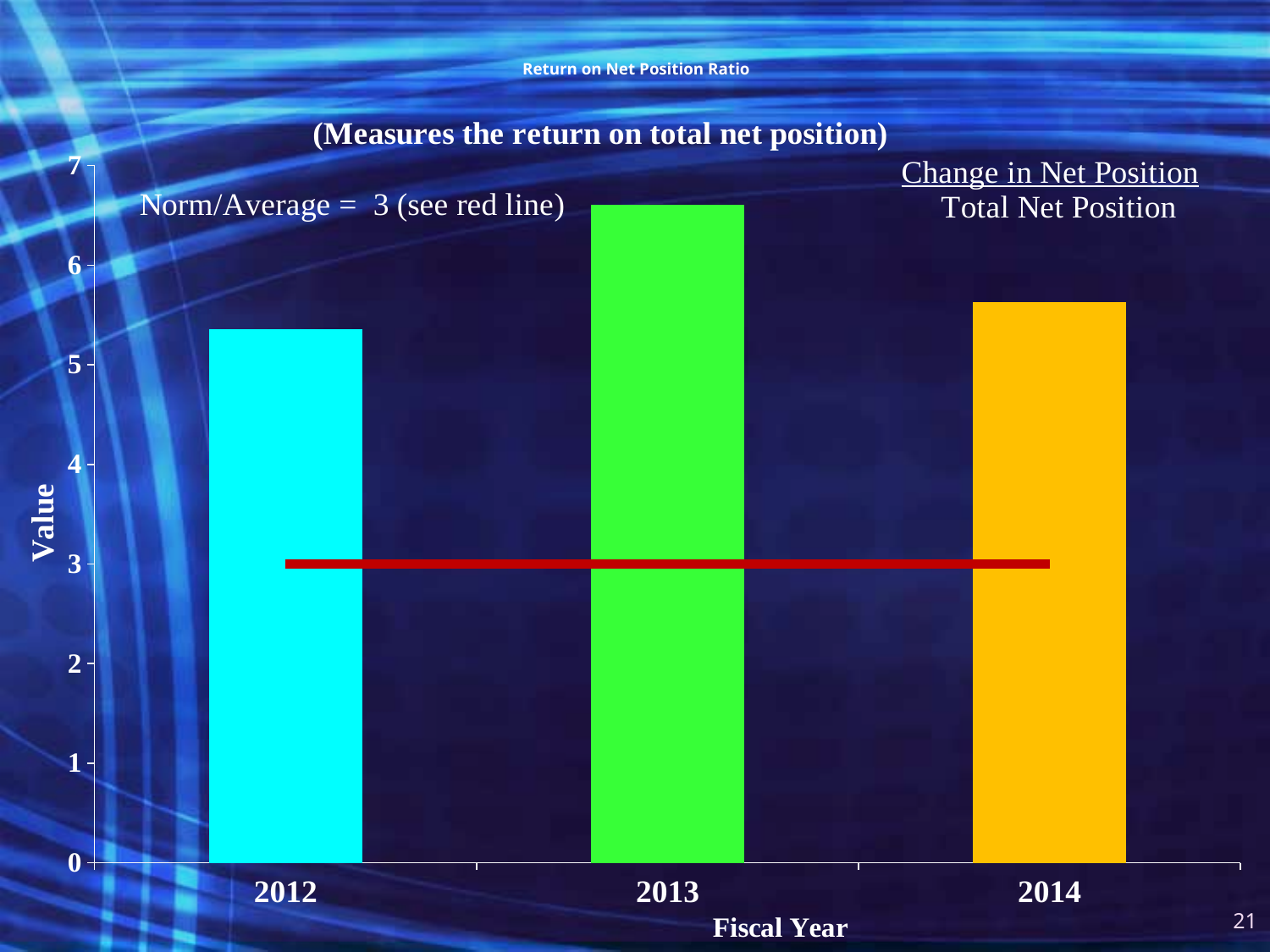
Does the value rise or fall from 2013 to 2014? fall What is the label of the x axis? Fiscal Year What kind of chart is shown on the slide? bar chart How many fiscal years are plotted on the chart? 3 Which fiscal year has the larger value, 2012 or 2013? 2013 Which fiscal year has the highest Return on Net Position Ratio? 2013 Which fiscal year has the larger value, 2012 or 2014? 2014 Which fiscal year has the lowest Return on Net Position Ratio? 2012 Is the value for 2013 greater or less than 6? greater What value does the red line on the chart represent as the Norm/Average? 3 Is the value for 2012 greater or less than 5? greater Is the value for 2014 greater or less than 6? less